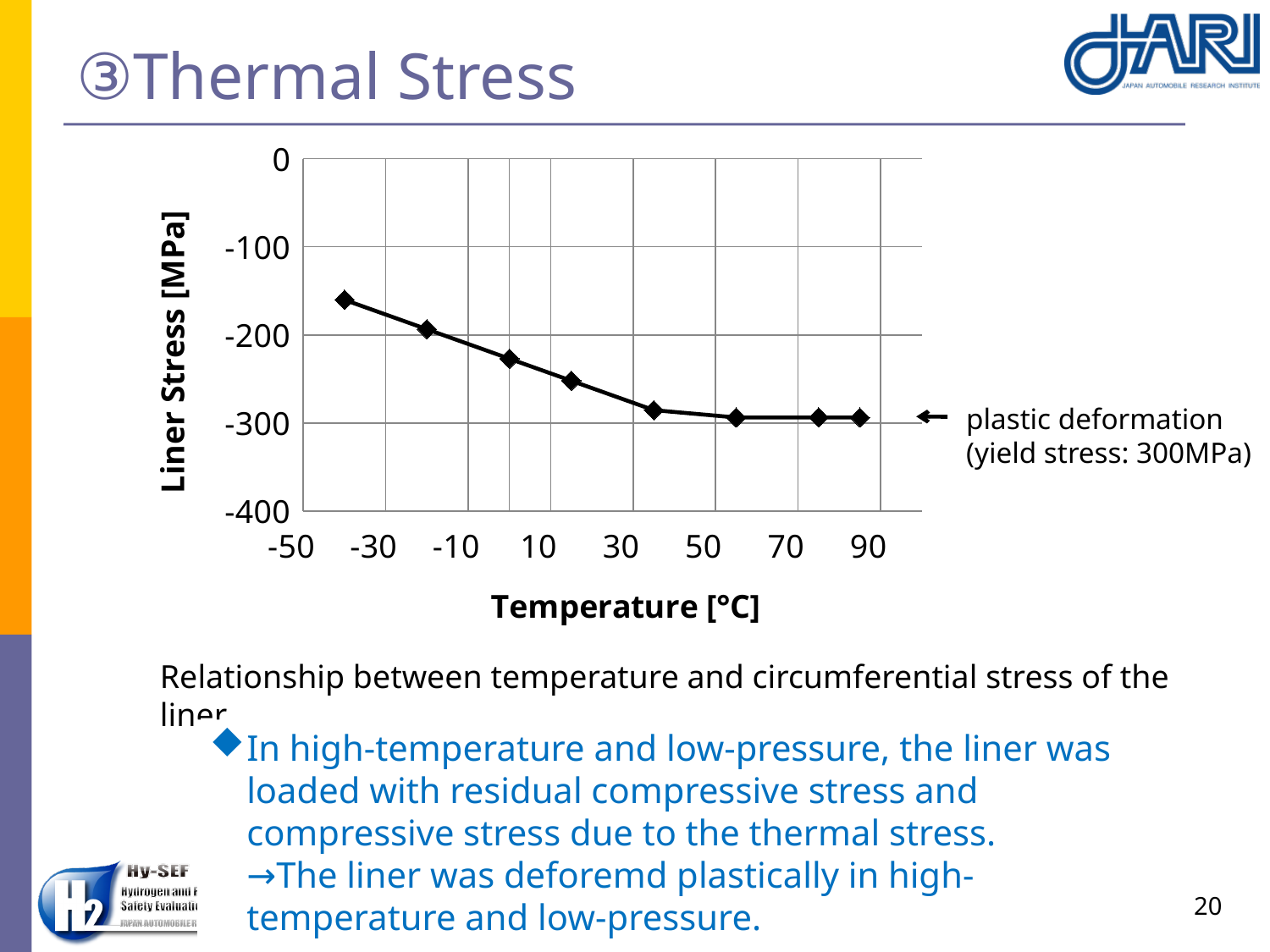
Does the liner stress rise or fall as temperature increases along the x axis? fall What kind of chart is shown on the slide? line chart At which temperature is the liner stress highest (least negative)? -40°C Which is larger, the liner stress at -40°C or the liner stress at 80°C? -40°C Is the liner stress at 80°C greater or less than -200 MPa? less Is the liner stress at 0°C greater or less than -300 MPa? greater What is the lowest value shown on the y axis? -400 Is the liner stress at 20°C greater or less than -200 MPa? less What is the title of the x axis? Temperature [°C] What is the title of the y axis? Liner Stress [MPa] How many data points are plotted on the line? 8